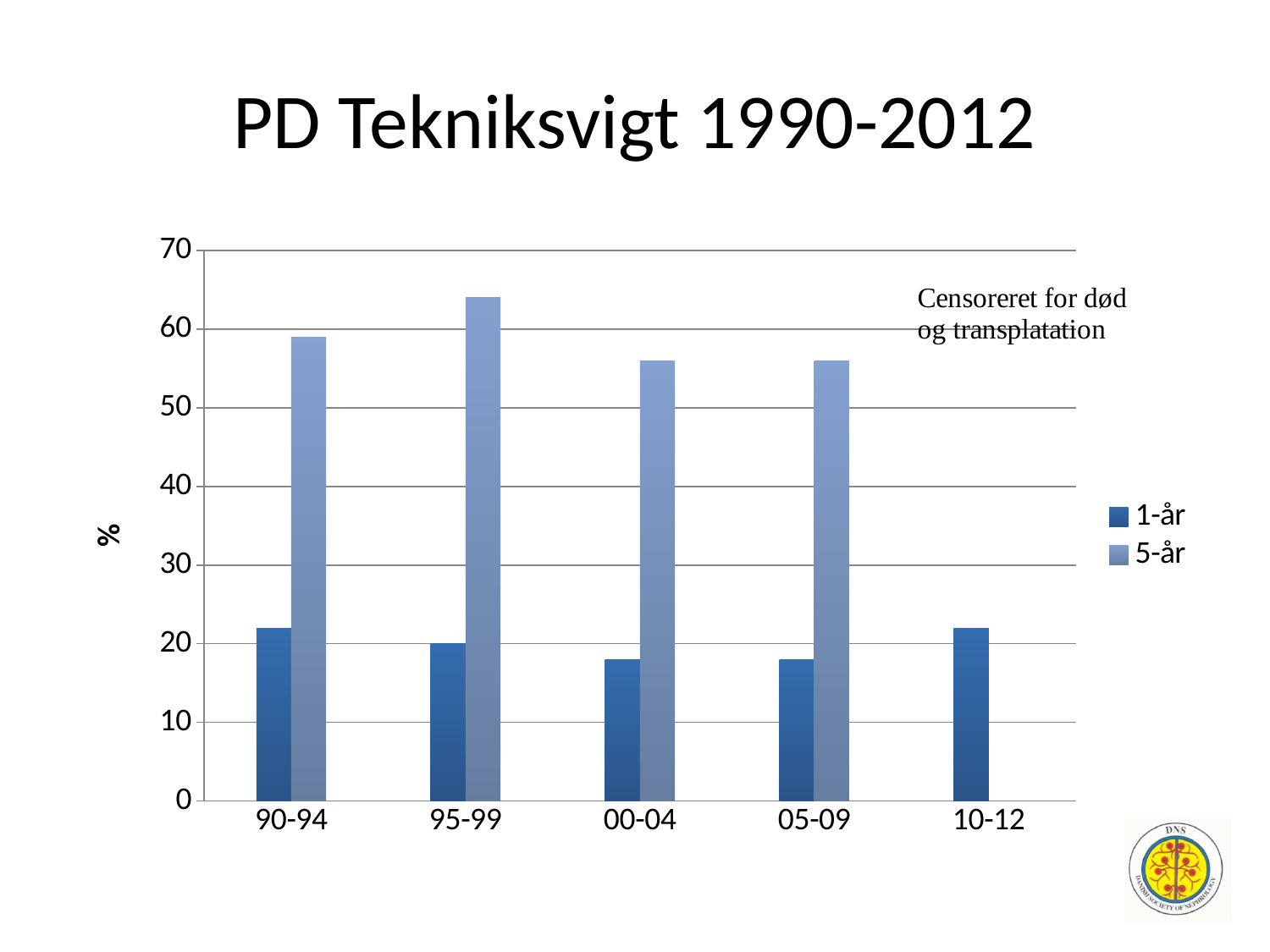
How many period categories are shown on the x axis? 5 How many series does the legend list? 2 Which is larger for 05-09, the 1-år value or the 5-år value? 5-år Is the 5-år value for 95-99 greater or less than 60? greater Is the 1-år value for 00-04 greater or less than 20? less What kind of chart is shown on the slide? bar chart Which period has no 5-år bar? 10-12 What is the title of the chart? PD Tekniksvigt 1990-2012 Which is larger, the 5-år value for 95-99 or the 5-år value for 90-94? 95-99 Is the 5-år value for 00-04 greater or less than 50? greater Which period has the highest 5-år value? 95-99